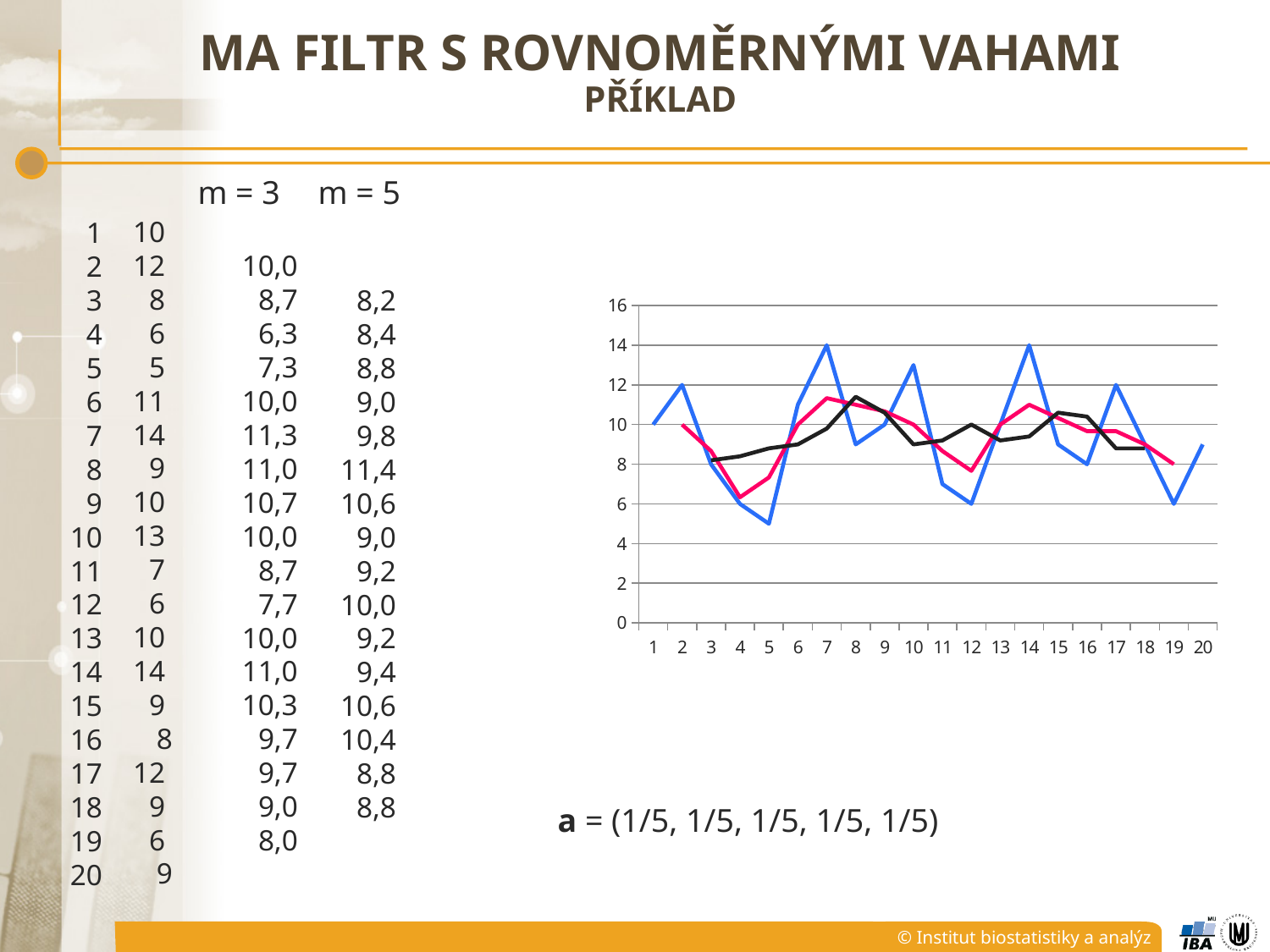
What is the difference between the blue line's value at x = 7 and its value at x = 4? 8 Does the blue line rise or fall between x = 2 and x = 5? fall Is the value of the blue line at x = 5 greater or less than 6? less At which x value does the blue line reach its lowest point? 5 Which is larger on the blue line: the value at x = 7 or the value at x = 12? x = 7 What is the value of the blue line at x = 7? 14 What kind of chart is shown on the slide? line chart How many points are labelled along the x axis of the chart? 20 How many lines are plotted in the chart? 3 What is the value of the blue line at x = 4? 6 Is the value of the black line at x = 8 greater or less than 10? greater What is the value of the blue line at x = 2? 12